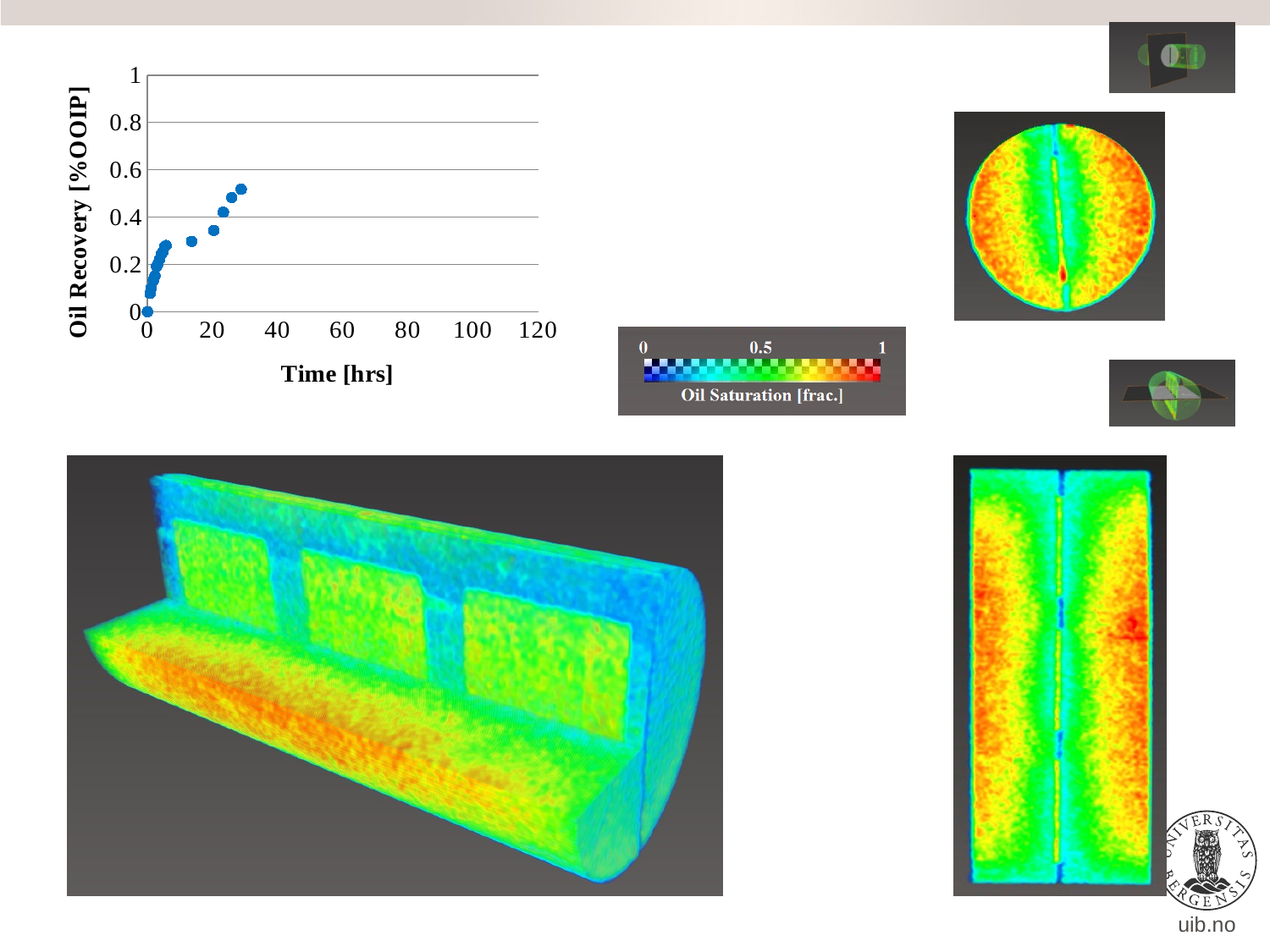
What kind of chart is shown on the slide? scatter chart Do the oil recovery values rise or fall as time increases along the x axis? rise What is the title of the horizontal axis of the chart? Time [hrs] Is the time of the last plotted point greater or less than 40 hrs? less Is the highest oil recovery value plotted greater or less than 0.6? less Is the highest oil recovery value plotted greater or less than 0.4? greater What is the title of the vertical axis of the chart? Oil Recovery [%OOIP]